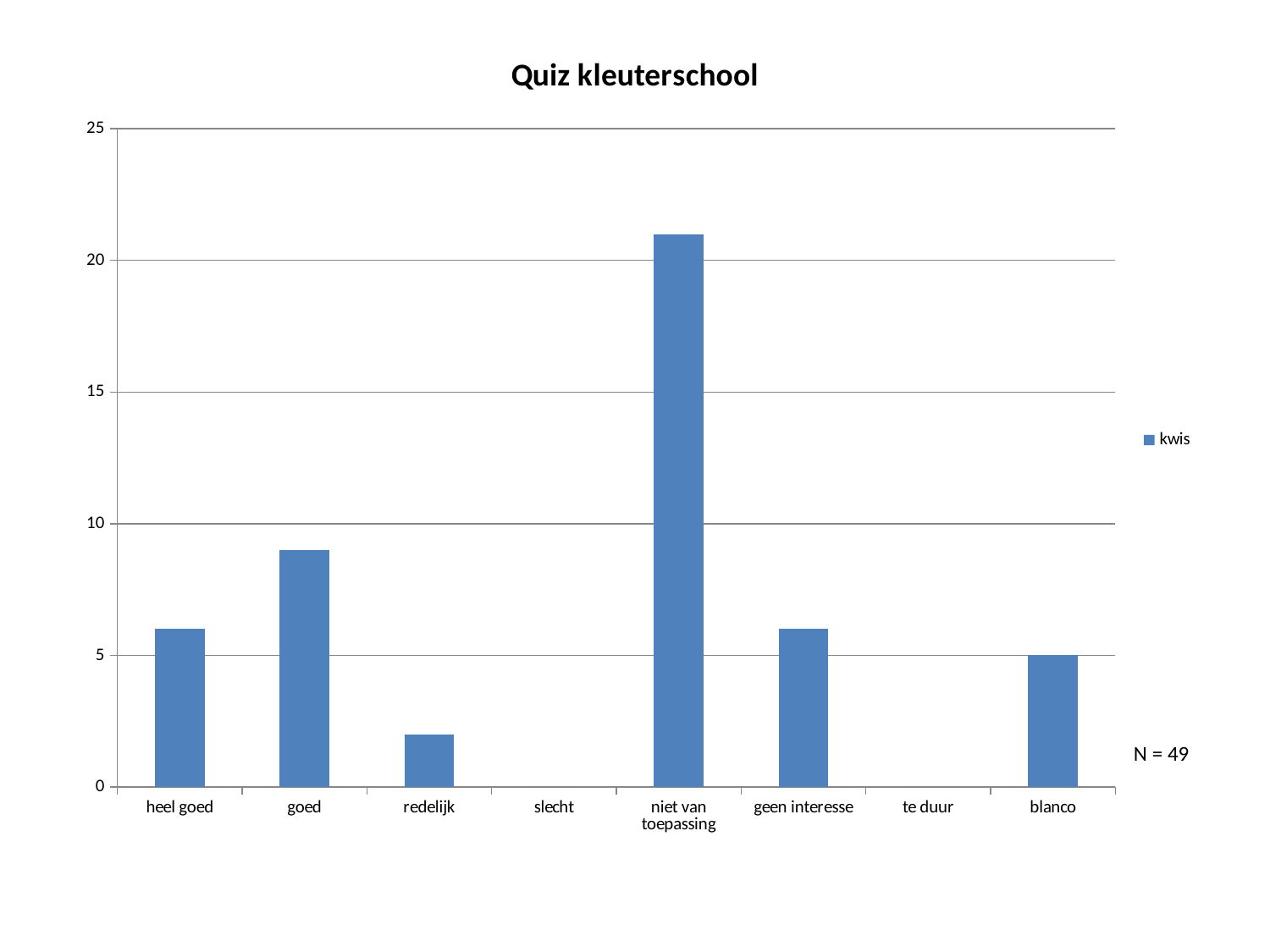
What is the value for slecht? 0 What is the name of the series in the legend? kwis How many categories are shown on the x axis? 8 Is the value for goed greater or less than 10? less What is the value for blanco? 5 How many series does the legend list? 1 What is the title of the chart? Quiz kleuterschool Is the value for redelijk greater or less than 5? less What type of chart is shown on the slide? bar chart Which is larger, the value for goed or the value for heel goed? goed Which category has the highest value? niet van toepassing Is the value for niet van toepassing greater or less than 20? greater